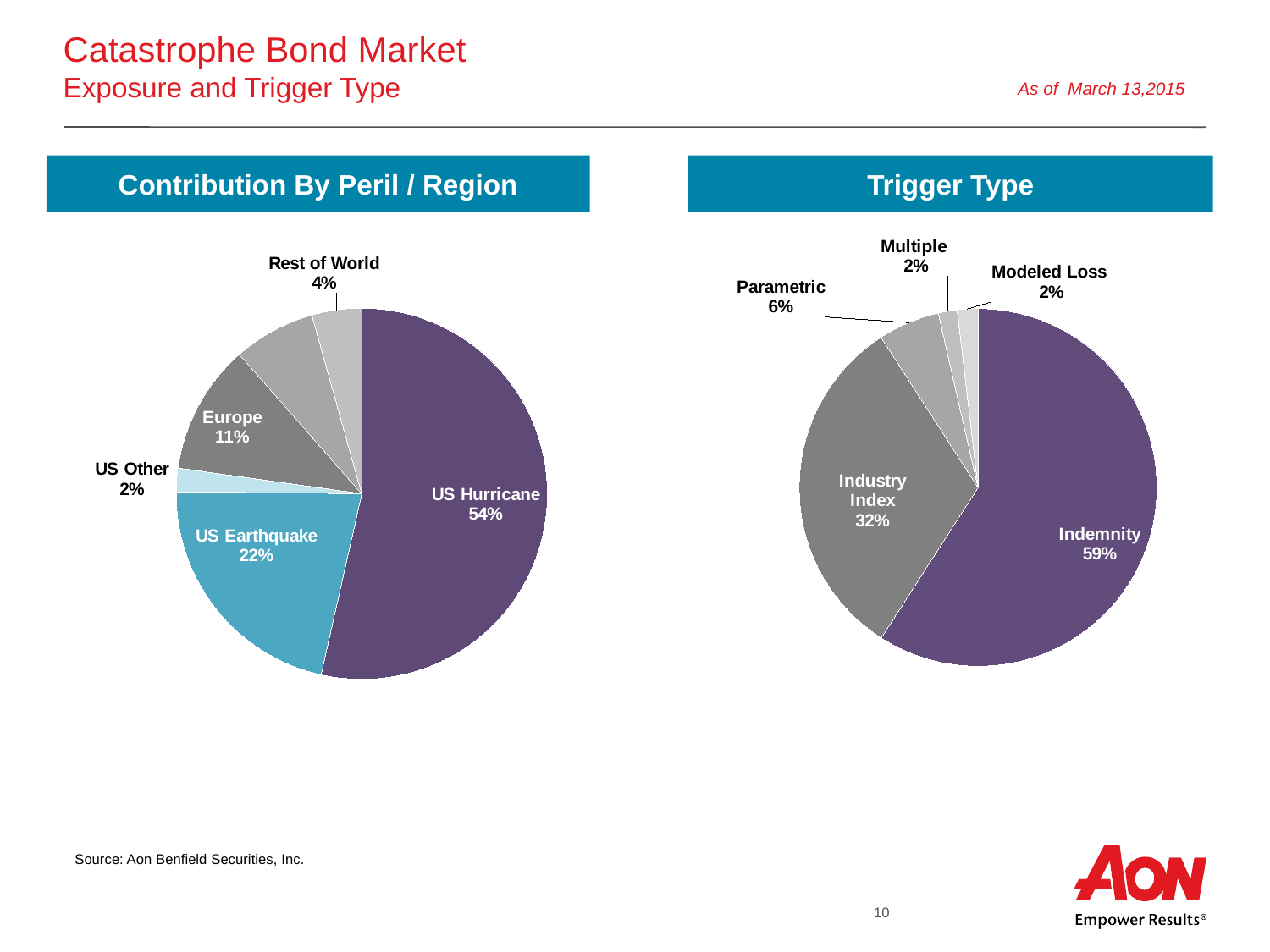
In the Trigger Type chart, what share does Indemnity have? 59% In the Trigger Type chart, what percentage is Parametric? 6% In the Contribution By Peril / Region chart, which category has the largest share? US Hurricane In the Trigger Type chart, what is the share for Industry Index? 32% In the Trigger Type chart, how many slices are there? 5 In the Contribution By Peril / Region chart, what is the difference between the US Hurricane and US Earthquake shares? 32% What type of chart is the Trigger Type chart? Pie chart In the Contribution By Peril / Region chart, which is larger, Europe or Rest of World? Europe In the Contribution By Peril / Region chart, what is the share for US Earthquake? 22% In the Contribution By Peril / Region chart, what percentage is Europe? 11% In the Contribution By Peril / Region chart, what share does US Hurricane have? 54% In the Trigger Type chart, what is the difference between Indemnity and Industry Index? 27%